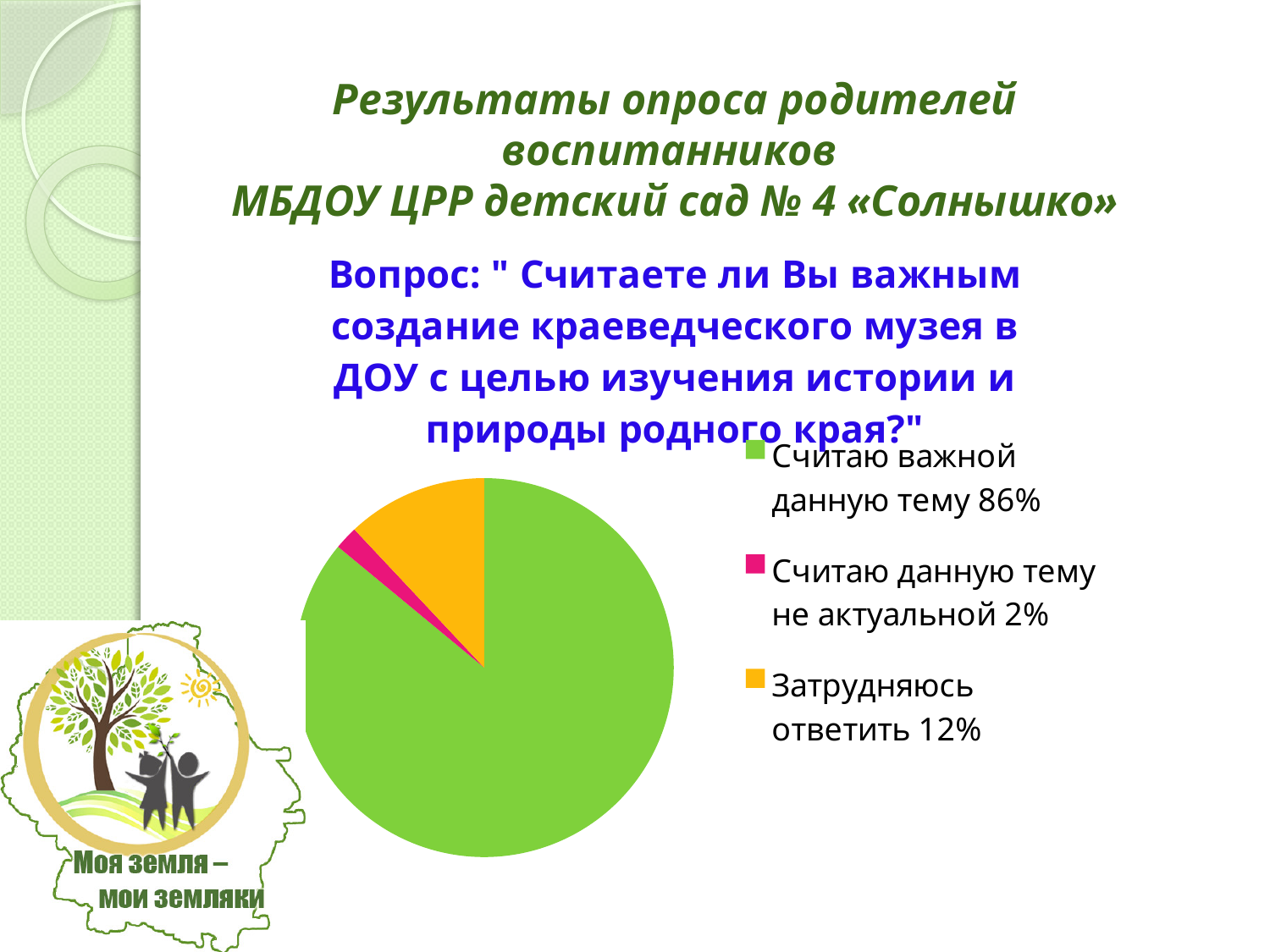
What share of respondents answered "Затрудняюсь ответить"? 12% How many entries does the legend of the pie chart list? 3 What colour is the slice for "Считаю важной данную тему"? green Which answer has the smallest share of the pie? Считаю данную тему не актуальной What share of respondents answered "Считаю данную тему не актуальной"? 2% What colour is the slice for "Затрудняюсь ответить"? orange What share of respondents answered "Считаю важной данную тему"? 86% What kind of chart is shown on the slide? pie chart Which answer has the largest share of the pie? Считаю важной данную тему What is the difference in percentage points between "Считаю важной данную тему" and "Затрудняюсь ответить"? 74 How many slices does the pie chart have? 3 Which is larger: the share for "Затрудняюсь ответить" or the share for "Считаю данную тему не актуальной"? Затрудняюсь ответить